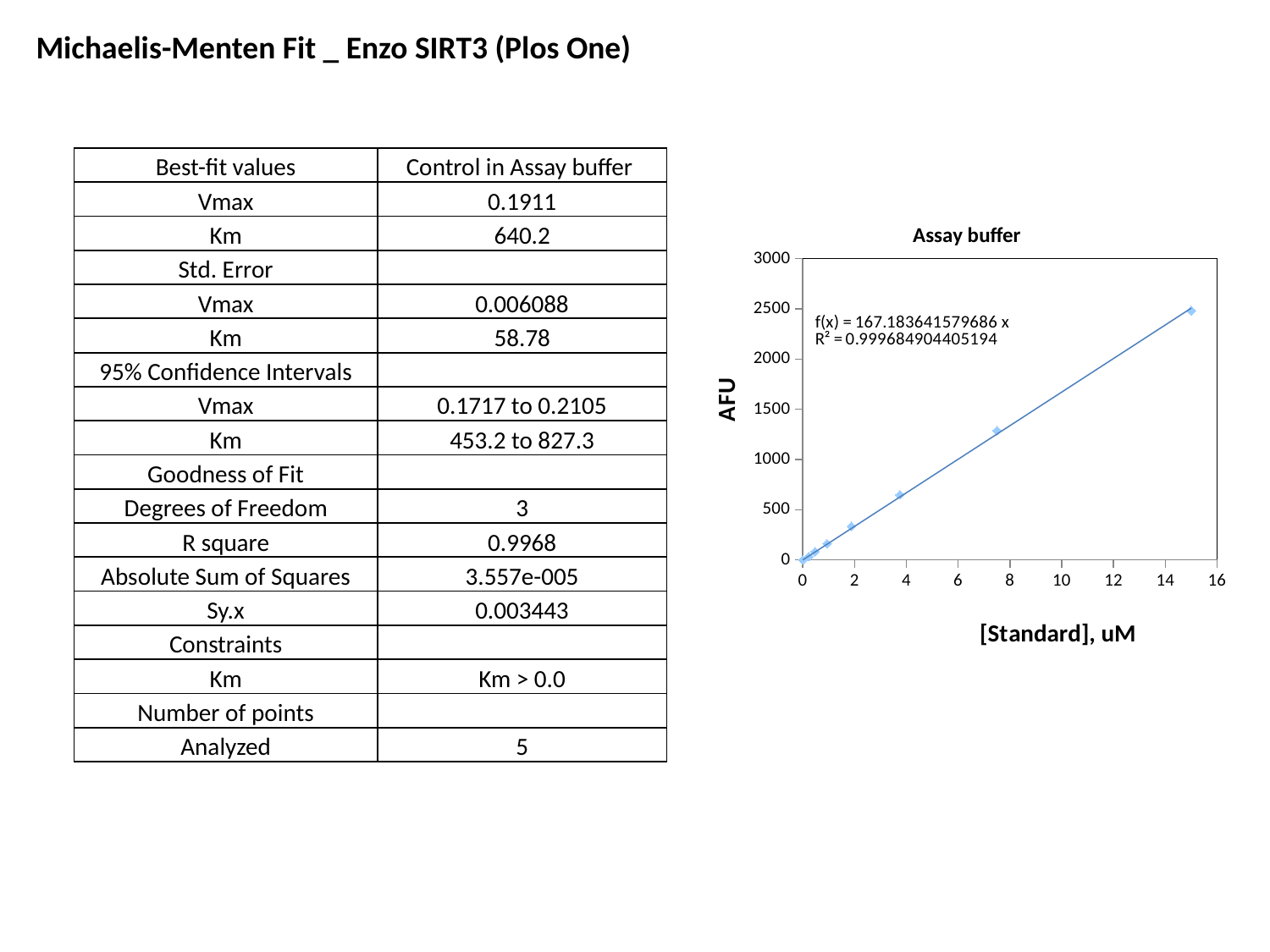
Is the AFU value for the point near 7.5 uM greater or less than 1500? less Is the AFU value for the point near 4 uM greater or less than 1000? less What kind of chart is shown on the slide? scatter chart What is the trendline equation printed on the chart? f(x) = 167.183641579686 x Is the AFU value for the point near 7.5 uM greater or less than 1000? greater What is the title of the chart? Assay buffer What is the label of the y axis of the chart? AFU Do the AFU values rise or fall as [Standard], uM increases along the x axis? rise What R² value is printed on the chart? 0.999684904405194 Which point has the highest AFU value, the one at 15 uM or the one near 7.5 uM? the one at 15 uM